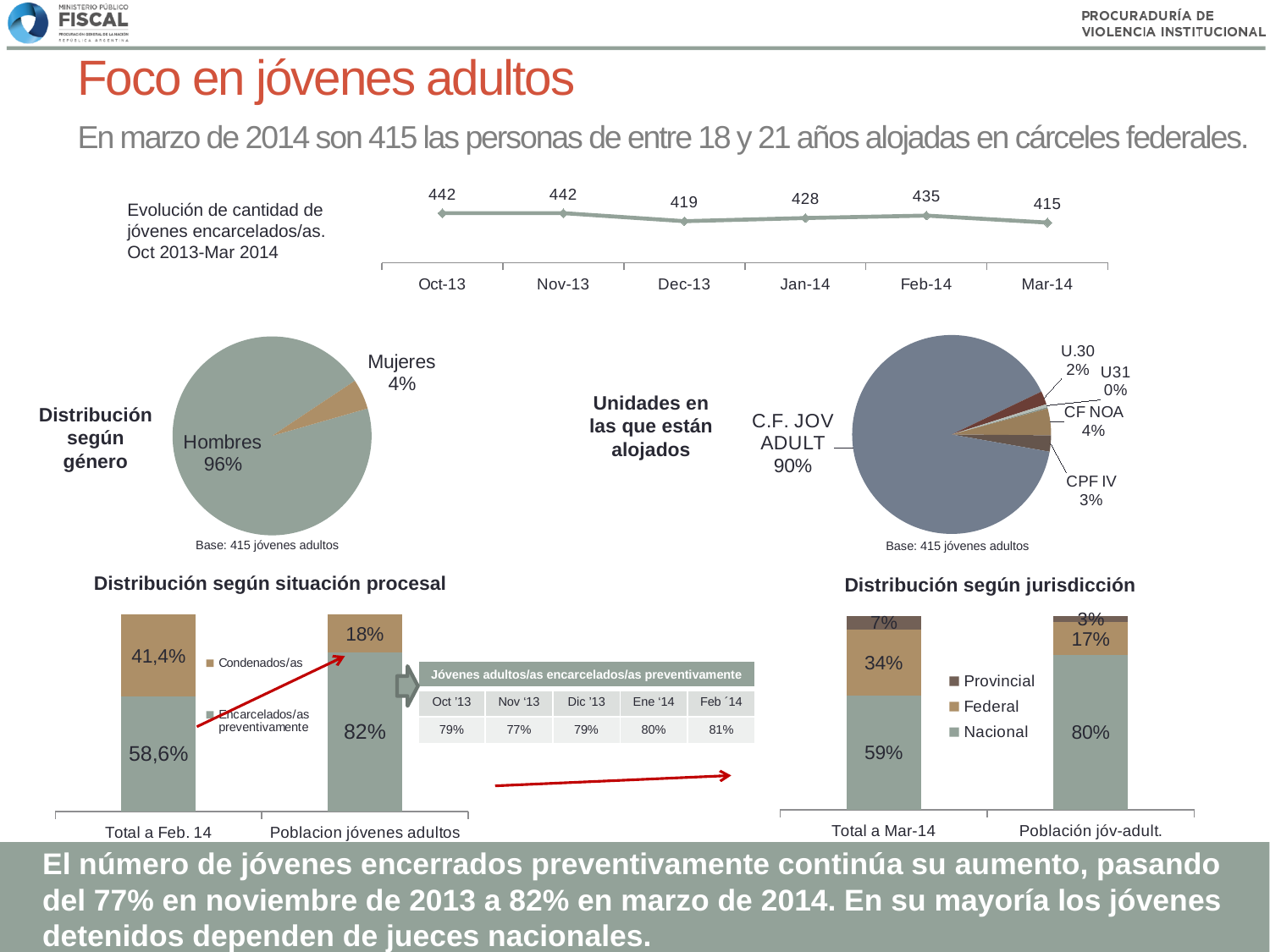
In the line chart 'Evolución de cantidad de jóvenes encarcelados/as', which month has the lowest value? Mar-14 In the line chart 'Evolución de cantidad de jóvenes encarcelados/as', how many months are plotted? 6 In the pie chart 'Unidades en las que están alojados', what share is CF NOA? 4% In the pie chart 'Unidades en las que están alojados', which unit has the largest share? C.F. JOV ADULT In the bar chart 'Distribución según situación procesal', what is the Condenados/as value for Poblacion jóvenes adultos? 18% In the bar chart 'Distribución según jurisdicción', how many series does the legend list? 3 In the line chart 'Evolución de cantidad de jóvenes encarcelados/as', what is the difference between the Oct-13 and Mar-14 values? 27 In the line chart 'Evolución de cantidad de jóvenes encarcelados/as', what is the value for Dec-13? 419 In the pie chart 'Distribución según género', what share is Mujeres? 4% In the bar chart 'Distribución según jurisdicción', what is the Nacional value for Población jóv-adult.? 80% In the bar chart 'Distribución según situación procesal', which bar has the larger Encarcelados/as preventivamente value, Total a Feb. 14 or Poblacion jóvenes adultos? Poblacion jóvenes adultos What kind of chart is 'Evolución de cantidad de jóvenes encarcelados/as'? Line chart